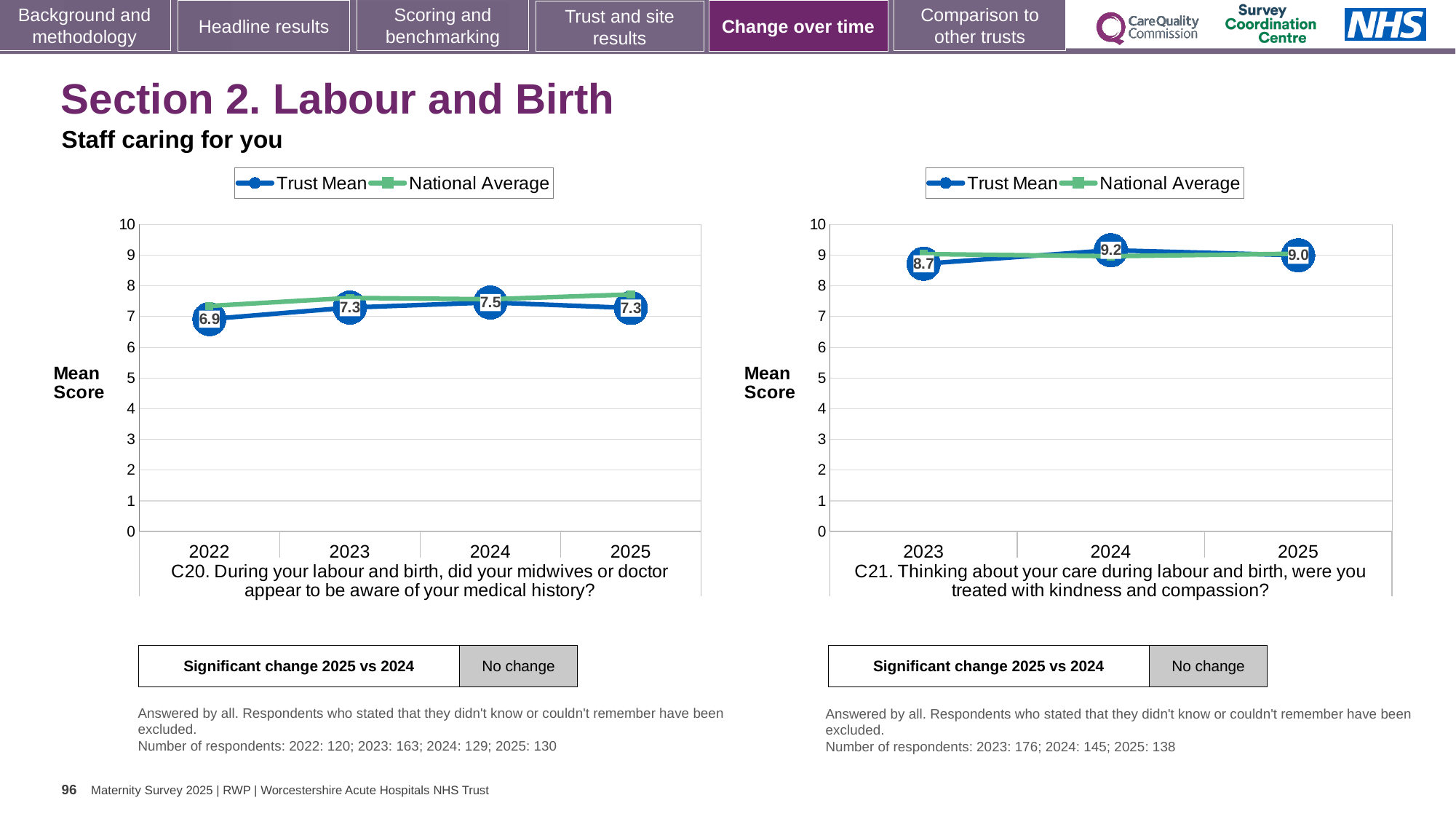
On the C20 chart (left), what is the difference between the Trust Mean scores for 2024 and 2022? 0.6 On the C20 chart (left), how many years are plotted on the x axis? 4 On the C21 chart (right), how many series does the legend list? 2 On the C20 chart (left), what is the Trust Mean score for 2024? 7.5 On the C21 chart (right), is the National Average value for 2023 greater or less than 8? greater On the C21 chart (right), what is the Trust Mean score for 2023? 8.7 On the C21 chart (right), what is the Trust Mean score for 2025? 9.0 On the C20 chart (left), which year has the highest Trust Mean score? 2024 On the C20 chart (left), what is the Trust Mean score for 2022? 6.9 On the C21 chart (right), what is the difference between the Trust Mean scores for 2024 and 2025? 0.2 On the C21 chart (right), which year has the lowest Trust Mean score? 2023 What type of chart is the C20 chart on the left? Line chart